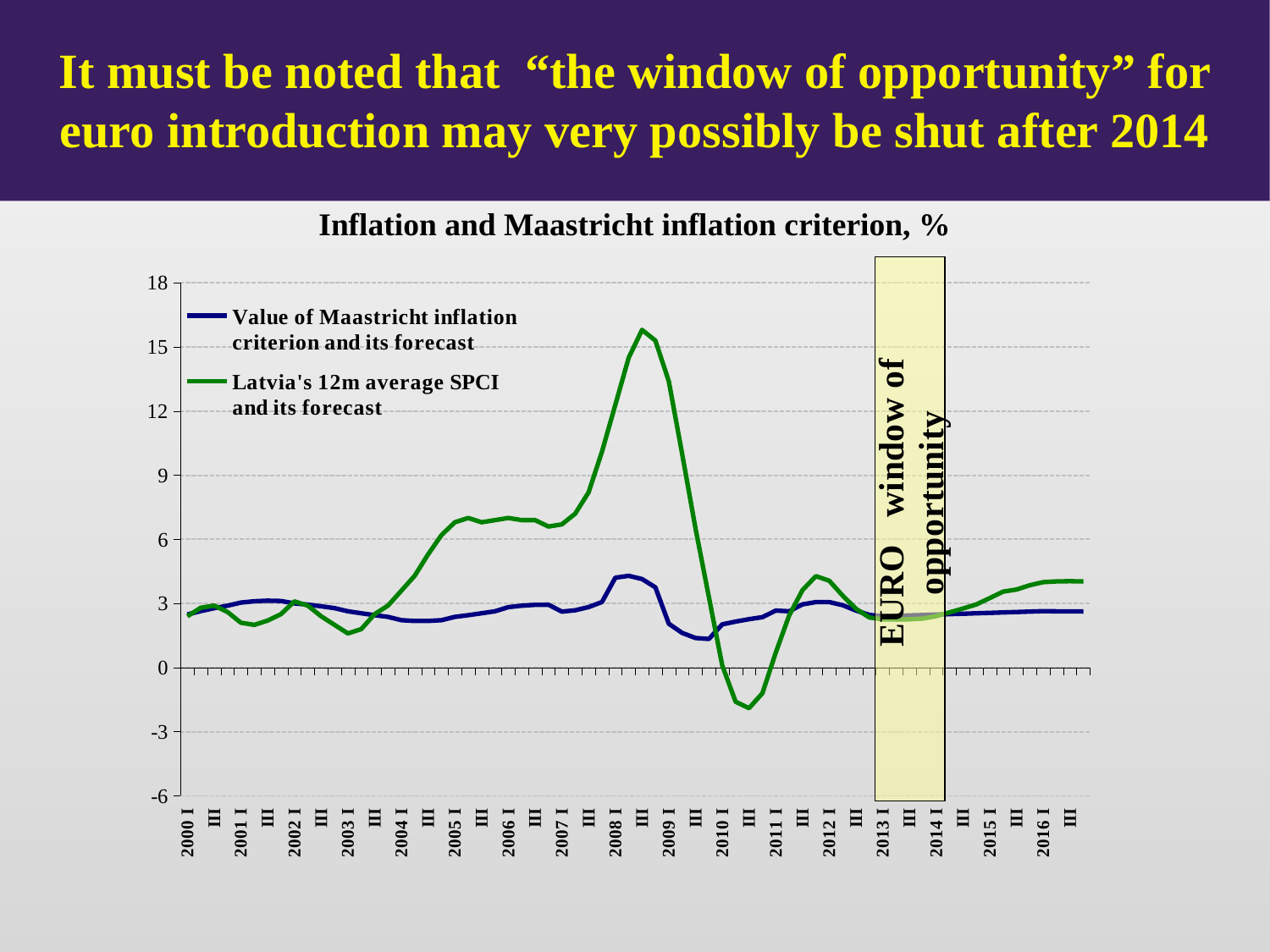
What label is written on the shaded vertical band covering 2013 and 2014? EURO window of opportunity Does Latvia's 12m average SPCI rise or fall between 2008 III and 2010 III? fall Which series reaches the highest value anywhere on the chart? Latvia's 12m average SPCI and its forecast Is the peak value of Latvia's 12m average SPCI around 2008 greater or less than 15? greater Is the value of Latvia's 12m average SPCI at 2010 III greater or less than 0? less How many series does the legend list? 2 Is the value of the Maastricht inflation criterion at 2008 I greater or less than 3? greater At 2008 III, which series has the higher value: the Maastricht inflation criterion or Latvia's 12m average SPCI? Latvia's 12m average SPCI What kind of chart is shown on the slide? line chart What is the title of the chart? Inflation and Maastricht inflation criterion, % At 2010 III, which series has the higher value: the Maastricht inflation criterion or Latvia's 12m average SPCI? Value of Maastricht inflation criterion